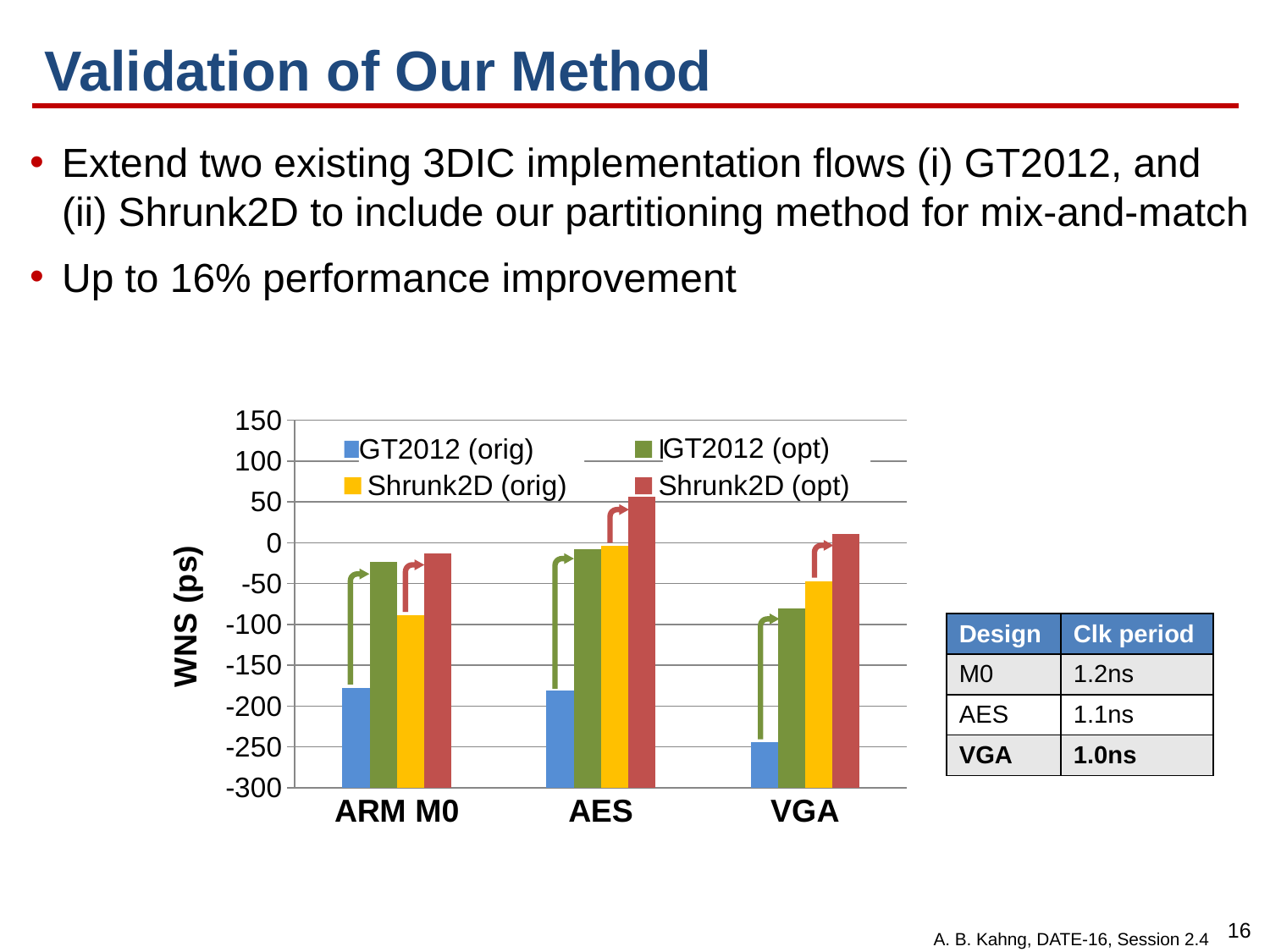
What kind of chart is shown on the slide? bar chart For ARM M0, which is larger: the GT2012 (orig) value or the Shrunk2D (orig) value? Shrunk2D (orig) Is the GT2012 (orig) value for VGA greater or less than -200? less Is the Shrunk2D (opt) value for AES greater or less than 0? greater For which design is the Shrunk2D (opt) WNS the highest? AES Is the GT2012 (orig) value for ARM M0 greater or less than -150? less How many series does the chart legend list? 4 What is the label of the y axis of the chart? WNS (ps) Which colour represents the GT2012 (orig) series in the chart? blue For which design is the GT2012 (orig) WNS the lowest? VGA How many designs (categories) are shown on the x axis of the chart? 3